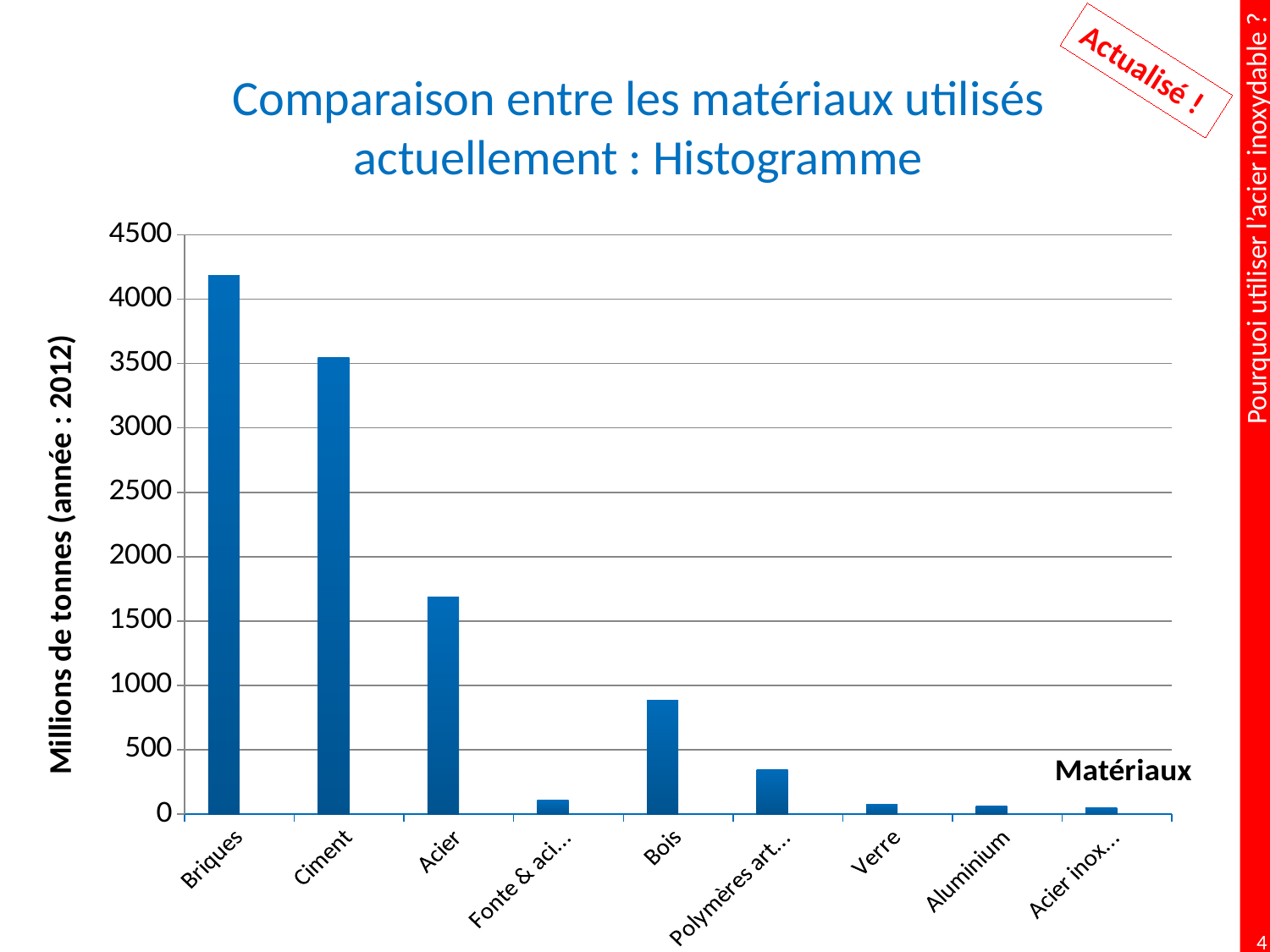
Which is larger, the value for Acier or the value for Bois? Acier Is the value for Ciment greater or less than 3000? greater What is the label of the horizontal axis? Matériaux What kind of chart is shown on the slide? Bar chart Which is larger, the value for Briques or the value for Ciment? Briques Is the value for Briques greater or less than 4000? greater Is the value for Bois greater or less than 1000? less What is the label of the vertical axis? Millions de tonnes (année : 2012) Which material has the highest value? Briques How many material categories are plotted on the x axis? 9